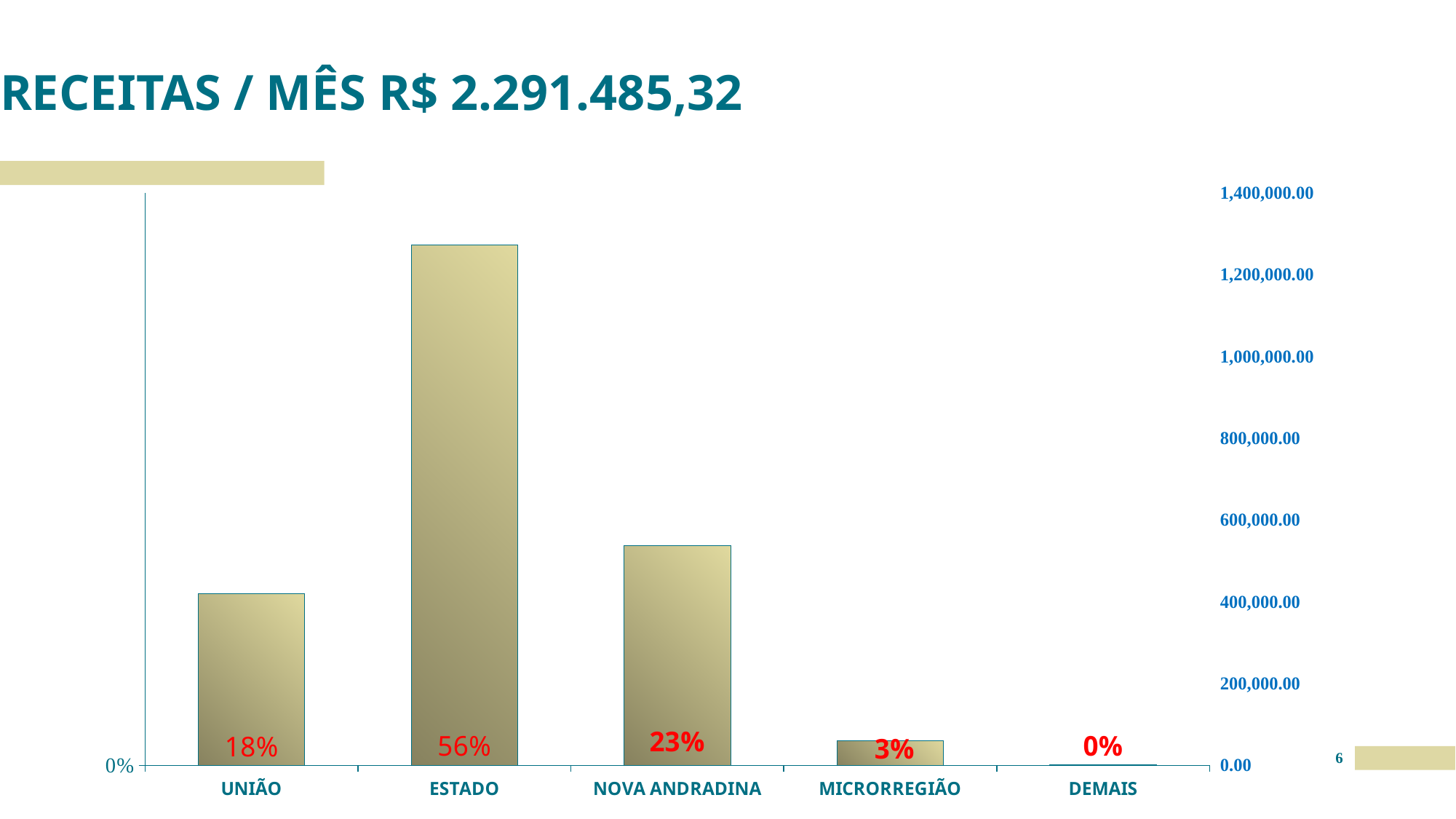
What percentage label is shown on the MICRORREGIÃO bar? 3% How many categories are shown on the x axis? 5 Is the value for MICRORREGIÃO greater or less than 200,000.00? less What percentage label is shown on the ESTADO bar? 56% Is the value for ESTADO greater or less than 1,200,000.00? greater Which category has the lowest value? DEMAIS Which category has the highest value? ESTADO Which is larger, the value for NOVA ANDRADINA or the value for UNIÃO? NOVA ANDRADINA What kind of chart is shown on the slide? Bar chart What percentage label is shown on the UNIÃO bar? 18% What percentage label is shown on the NOVA ANDRADINA bar? 23% What is the difference in percentage points between the ESTADO and UNIÃO labels? 38 percentage points